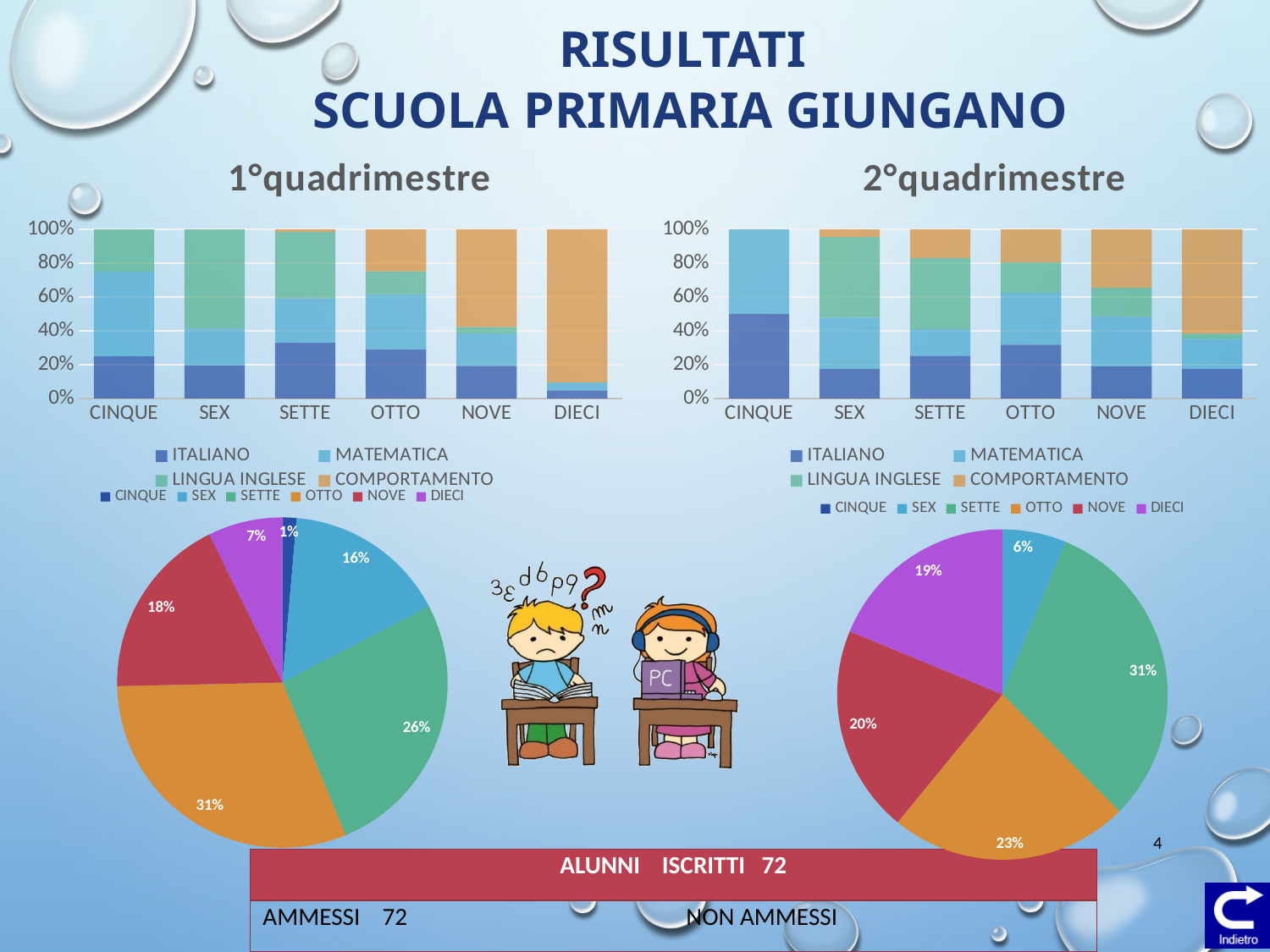
In the left pie chart (below 1°quadrimestre), what is the difference between the shares for SETTE and NOVE? 8% In the right pie chart (below 2°quadrimestre), what is the share for SETTE? 31% How many series does the legend of the 2°quadrimestre bar chart list? 4 What kind of chart is the 1°quadrimestre chart? Stacked bar chart In the 2°quadrimestre bar chart, is the ITALIANO value for CINQUE greater or less than 40%? greater How many categories are shown on the x axis of the 1°quadrimestre bar chart? 6 In the right pie chart (below 2°quadrimestre), which category has the largest share? SETTE In the left pie chart (below 1°quadrimestre), what is the share for SEX? 16% In the right pie chart (below 2°quadrimestre), what is the difference between the shares for OTTO and NOVE? 3% In the right pie chart (below 2°quadrimestre), which is larger, the share for OTTO or the share for DIECI? OTTO In the left pie chart (below 1°quadrimestre), which category has the smallest share? CINQUE In the left pie chart (below 1°quadrimestre), what is the share for OTTO? 31%